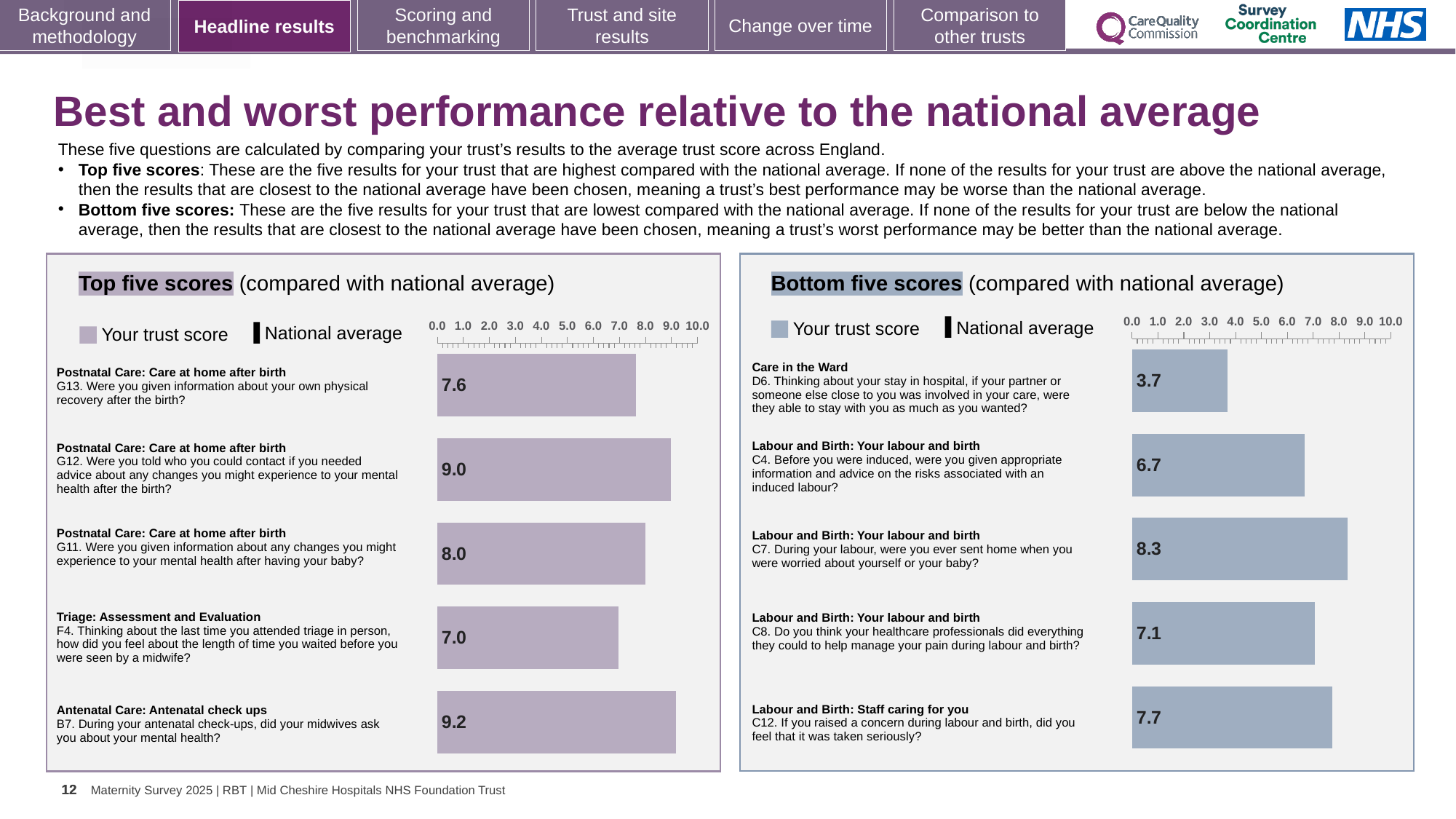
In the Bottom five scores chart, what is the trust score for C8 (help to manage your pain during labour and birth)? 7.1 In the Bottom five scores chart, what is the difference between the scores for C7 and D6? 4.6 In the Top five scores chart, what is the difference between the scores for B7 and F4? 2.2 In the Bottom five scores chart, what is the trust score for D6 (partner able to stay with you as much as you wanted)? 3.7 In the Top five scores chart, which question has the highest trust score? B7 In the Top five scores chart, what is the trust score for B7 (midwives asking about your mental health at antenatal check-ups)? 9.2 In the Top five scores chart, what is the trust score for G13 (information about your own physical recovery after the birth)? 7.6 How many questions are shown in the Bottom five scores chart? 5 In the Top five scores chart, which question has the lowest trust score? F4 What kind of chart is the Top five scores chart? Bar chart In the Bottom five scores chart, which question has the lowest trust score? D6 In the Top five scores chart, which has the larger score, G12 or G11? G12